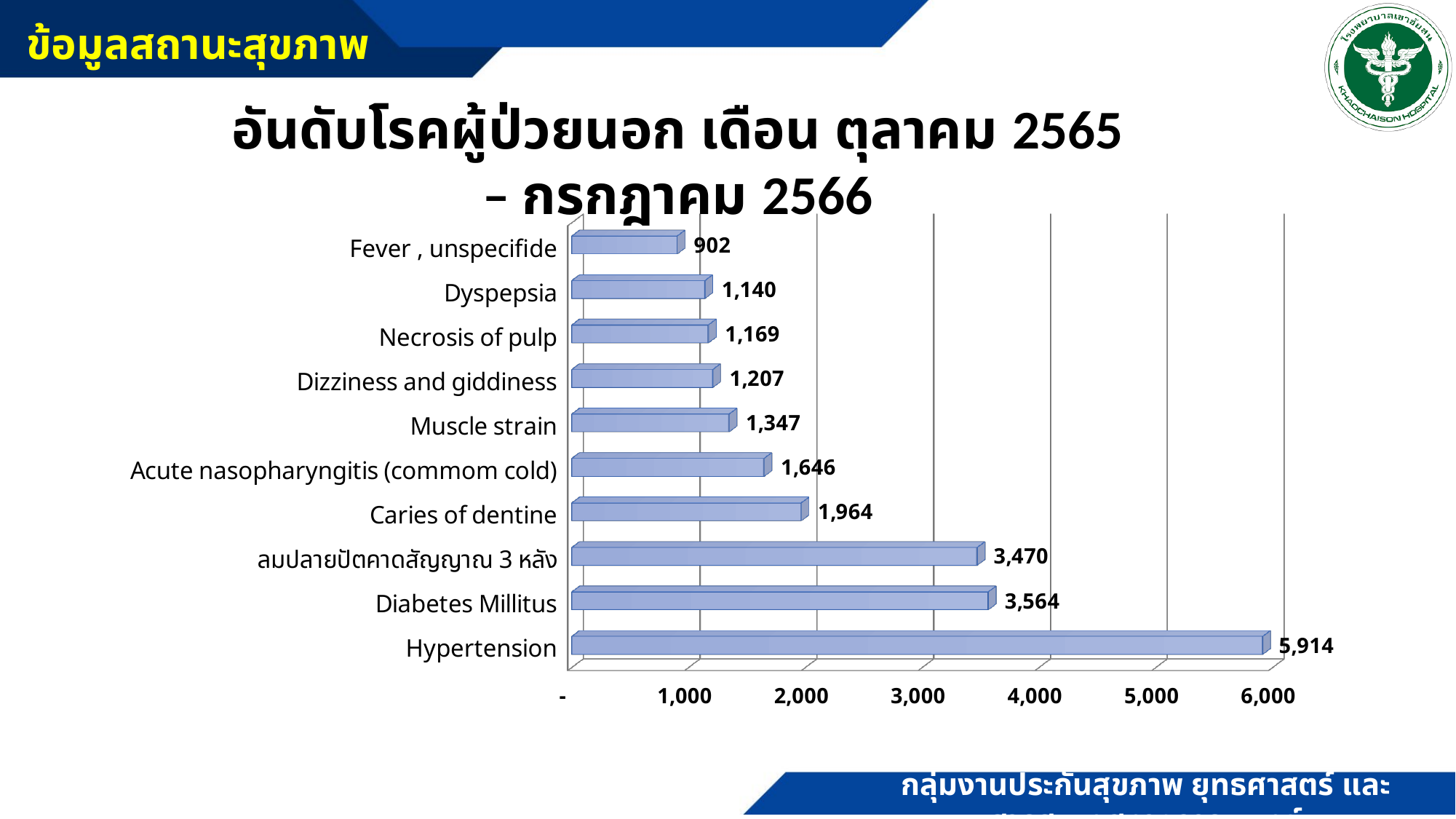
Which category has the highest value? Hypertension What is the value for Caries of dentine? 1,964 Which is larger, the value for Dyspepsia or the value for Necrosis of pulp? Necrosis of pulp What is the value for Acute nasopharyngitis (commom cold)? 1,646 How many categories are shown in the chart? 10 Is the value for Caries of dentine greater or less than 2,000? less What kind of chart is shown on the slide? bar chart What is the value for Diabetes Millitus? 3,564 Which category has the lowest value? Fever , unspecifide What is the difference between the values for Hypertension and Diabetes Millitus? 2,350 What is the difference between the values for Muscle strain and Dizziness and giddiness? 140 What is the value for Hypertension? 5,914